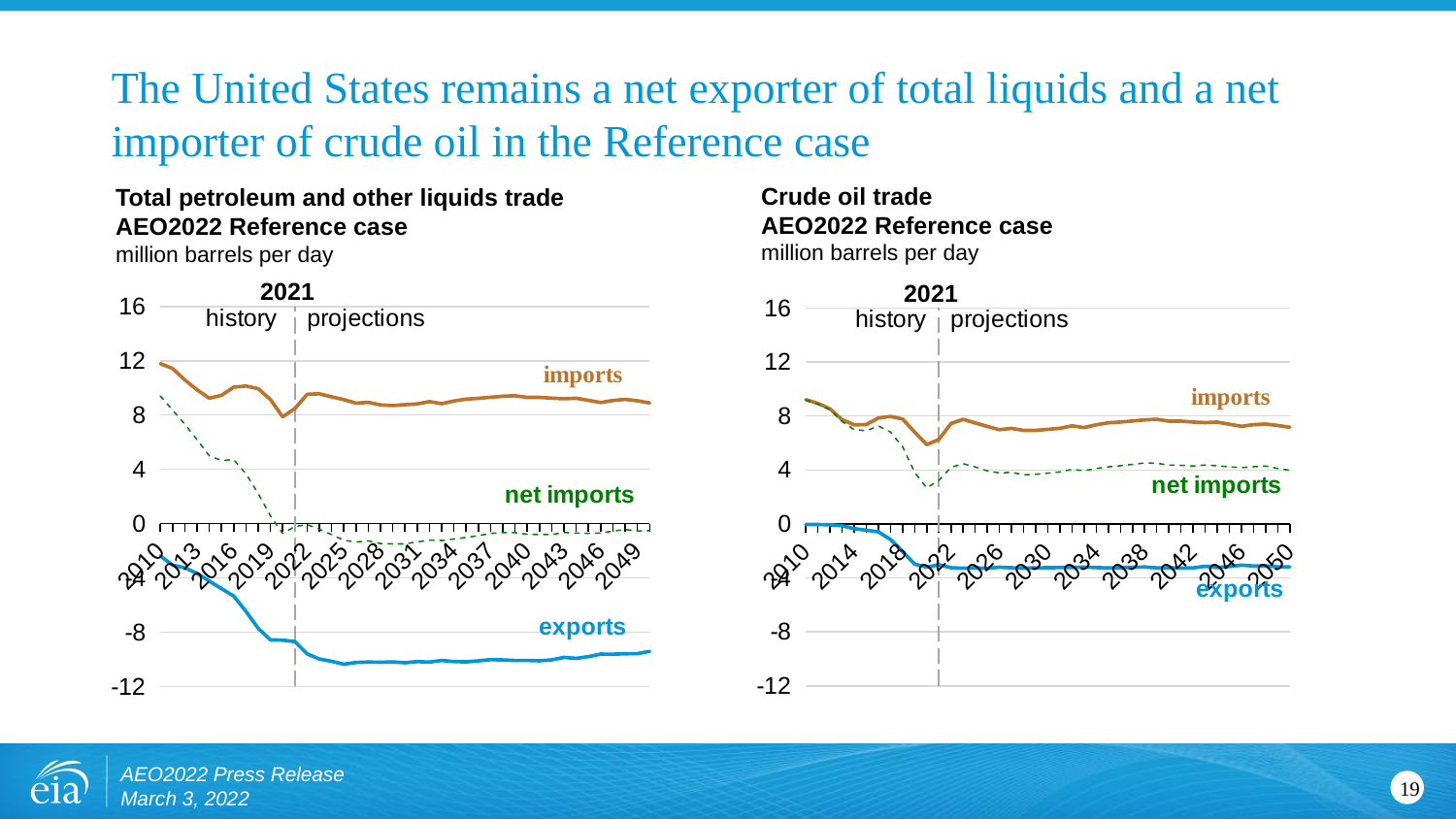
On the 'Total petroleum and other liquids trade' chart, do exports rise or fall between 2010 and 2022? fall Which year does the vertical dashed line separating history from projections mark on the charts? 2021 On the 'Total petroleum and other liquids trade' chart, which is larger in 2040: imports or net imports? imports How many series are plotted on the 'Crude oil trade' chart on the right? 3 What unit of measurement is used on both charts? million barrels per day On the 'Total petroleum and other liquids trade' chart, is the value for imports in 2010 greater or less than 8? greater On the 'Crude oil trade' chart, do net imports rise or fall between 2010 and 2021? fall On the 'Crude oil trade' chart, is the value for net imports in 2050 greater or less than 8? less On the 'Crude oil trade' chart, is the value for imports in 2010 greater or less than 8? greater What kind of chart is the 'Total petroleum and other liquids trade' chart on the left? line chart